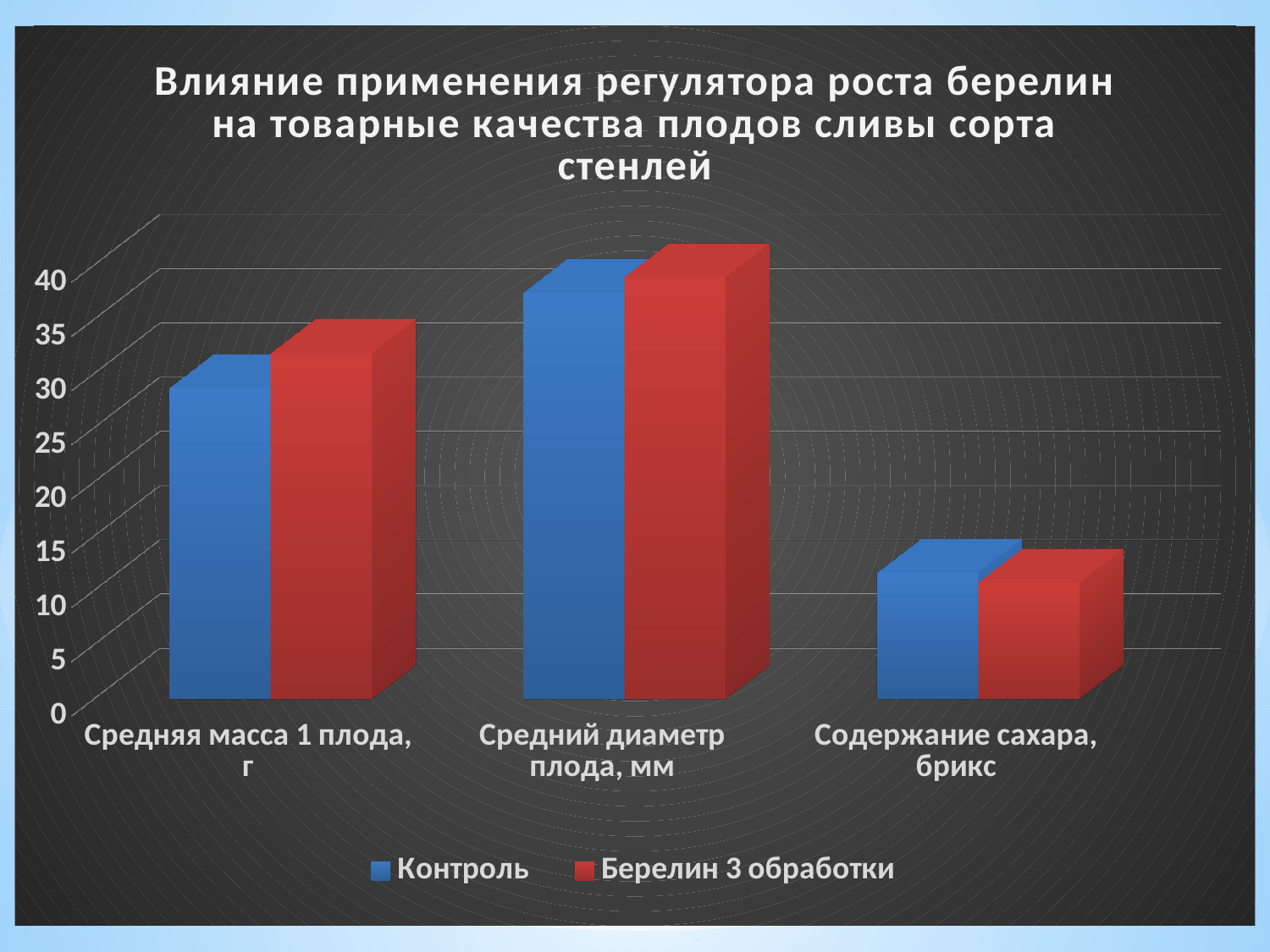
How many series does the legend list? 2 What is the title of the chart? Влияние применения регулятора роста берелин на товарные качества плодов сливы сорта стенлей For 'Средняя масса 1 плода, г', which series has the larger value: Контроль or Берелин 3 обработки? Берелин 3 обработки Is the Берелин 3 обработки value for 'Средний диаметр плода, мм' greater or less than 30? greater Which category has the highest values in the chart? Средний диаметр плода, мм How many categories are shown on the x axis of the chart? 3 Which series is shown in red in the chart? Берелин 3 обработки For 'Средний диаметр плода, мм', which series has the larger value: Контроль or Берелин 3 обработки? Берелин 3 обработки Is the Контроль value for 'Средняя масса 1 плода, г' greater or less than 20? greater What kind of chart is shown on the slide? bar chart Which category has the lowest values in the chart? Содержание сахара, брикс Is the Контроль value for 'Содержание сахара, брикс' greater or less than 20? less